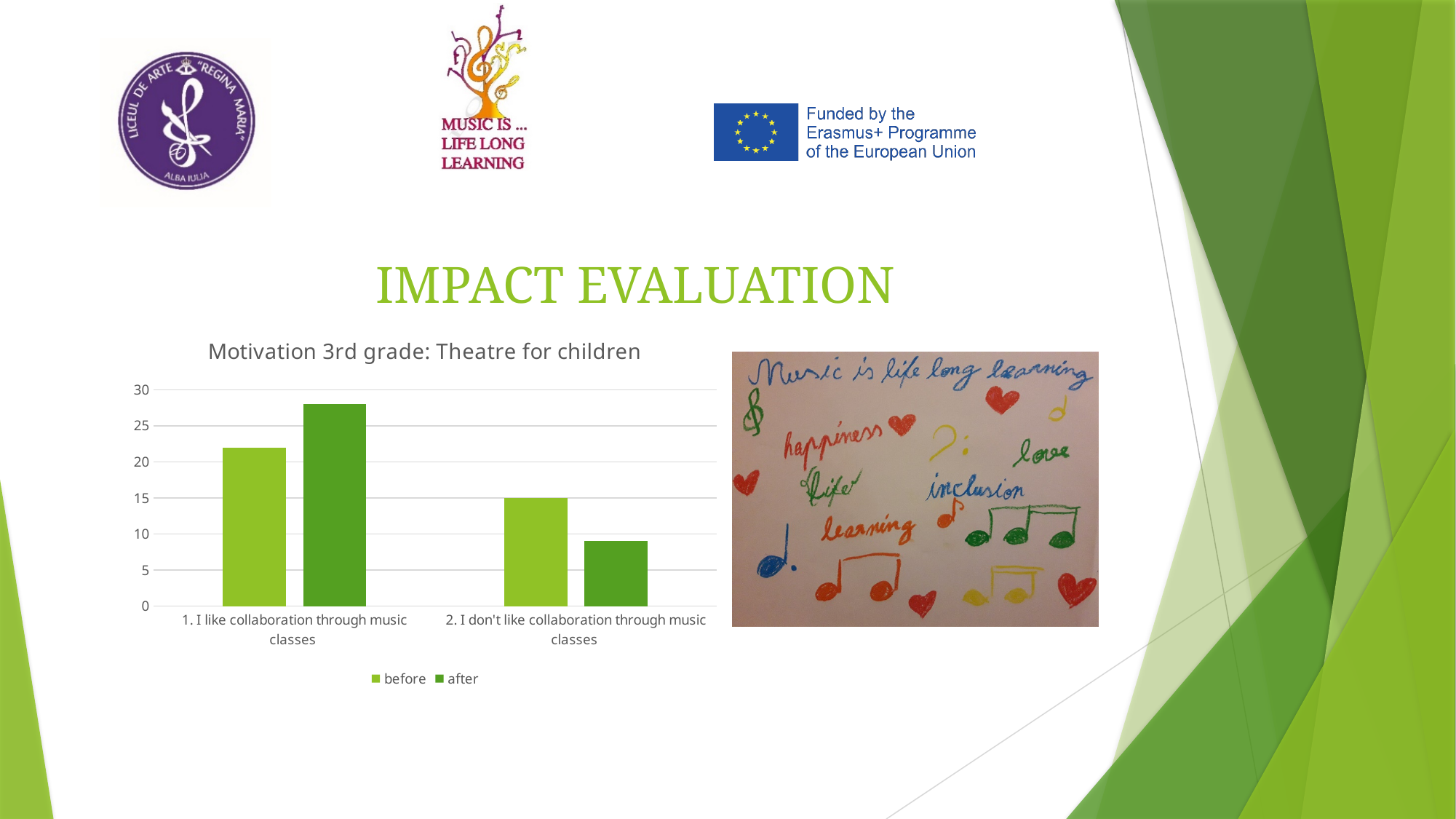
In the "Motivation 3rd grade: Theatre for children" chart, is the "after" value for "1. I like collaboration through music classes" greater or less than 25? greater What are the two series named in the legend of the "Motivation 3rd grade: Theatre for children" chart? before and after How many series does the legend of the "Motivation 3rd grade: Theatre for children" chart list? 2 In the "Motivation 3rd grade: Theatre for children" chart, which bar is the tallest overall? after, 1. I like collaboration through music classes In the "Motivation 3rd grade: Theatre for children" chart, is the "before" value for "1. I like collaboration through music classes" greater or less than 20? greater How many categories are shown on the x axis of the "Motivation 3rd grade: Theatre for children" chart? 2 In the "Motivation 3rd grade: Theatre for children" chart, which bar is the shortest overall? after, 2. I don't like collaboration through music classes In the "Motivation 3rd grade: Theatre for children" chart, which is larger for "1. I like collaboration through music classes": the "before" bar or the "after" bar? after What is the title of the chart on the slide? Motivation 3rd grade: Theatre for children In the "Motivation 3rd grade: Theatre for children" chart, which is larger for "2. I don't like collaboration through music classes": the "before" bar or the "after" bar? before In the "Motivation 3rd grade: Theatre for children" chart, is the "after" value for "2. I don't like collaboration through music classes" greater or less than 10? less What kind of chart is shown under the title "Motivation 3rd grade: Theatre for children"? bar chart